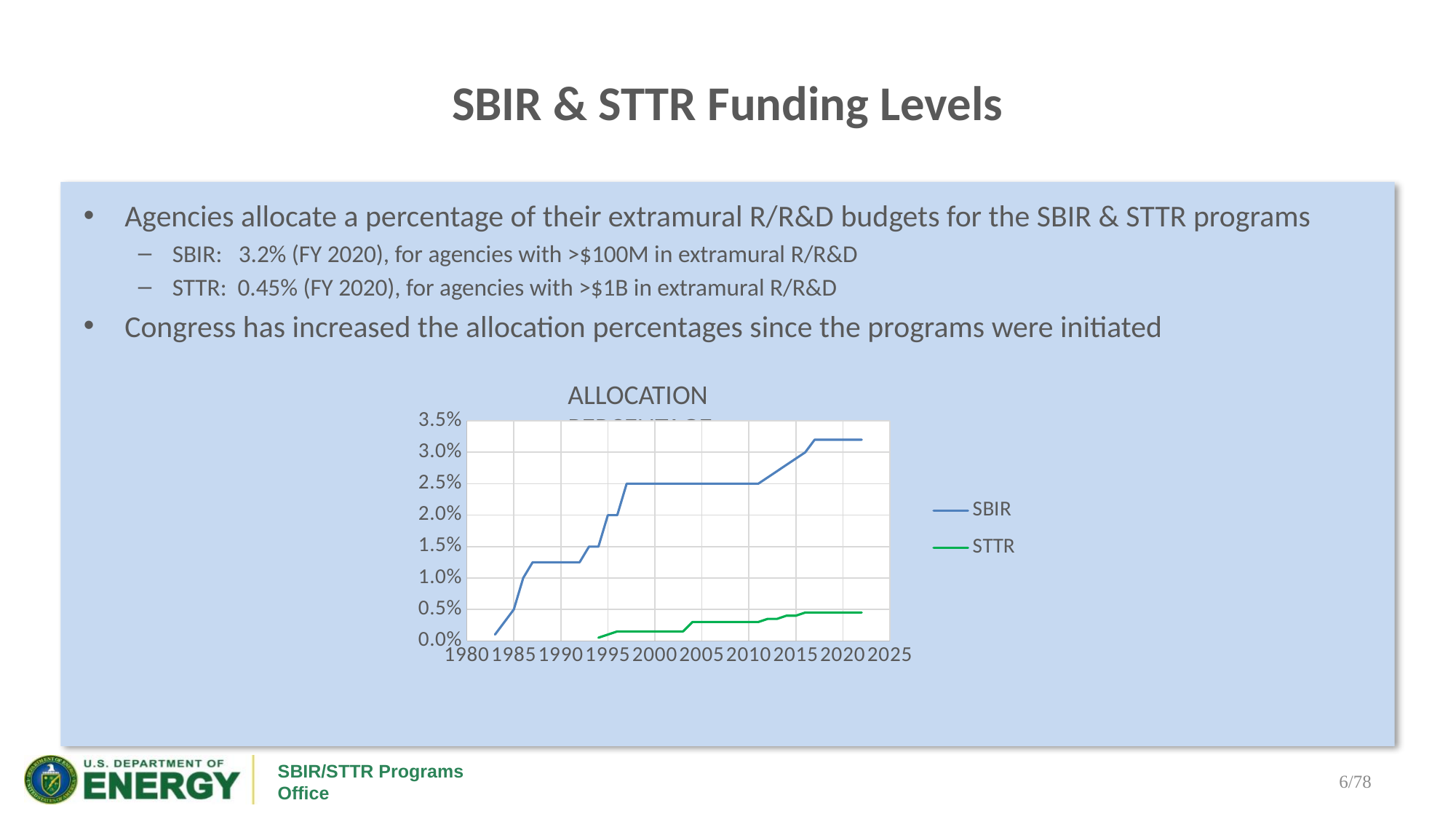
What kind of chart is shown on the slide? line chart Is the STTR value in 2010 greater or less than 0.5%? less Is the SBIR value in 2010 greater or less than 2.0%? greater How many series does the chart's legend list? 2 What colour is the SBIR line in the chart? blue Does the STTR allocation percentage rise or fall from 1995 to 2020? rise Is the STTR value in 2000 greater or less than 0.5%? less Does the SBIR allocation percentage rise or fall from 1980 to 2020? rise Which series has the higher value in 2020, SBIR or STTR? SBIR Which two series are listed in the chart's legend? SBIR and STTR Which series reaches the highest allocation percentage on the chart? SBIR